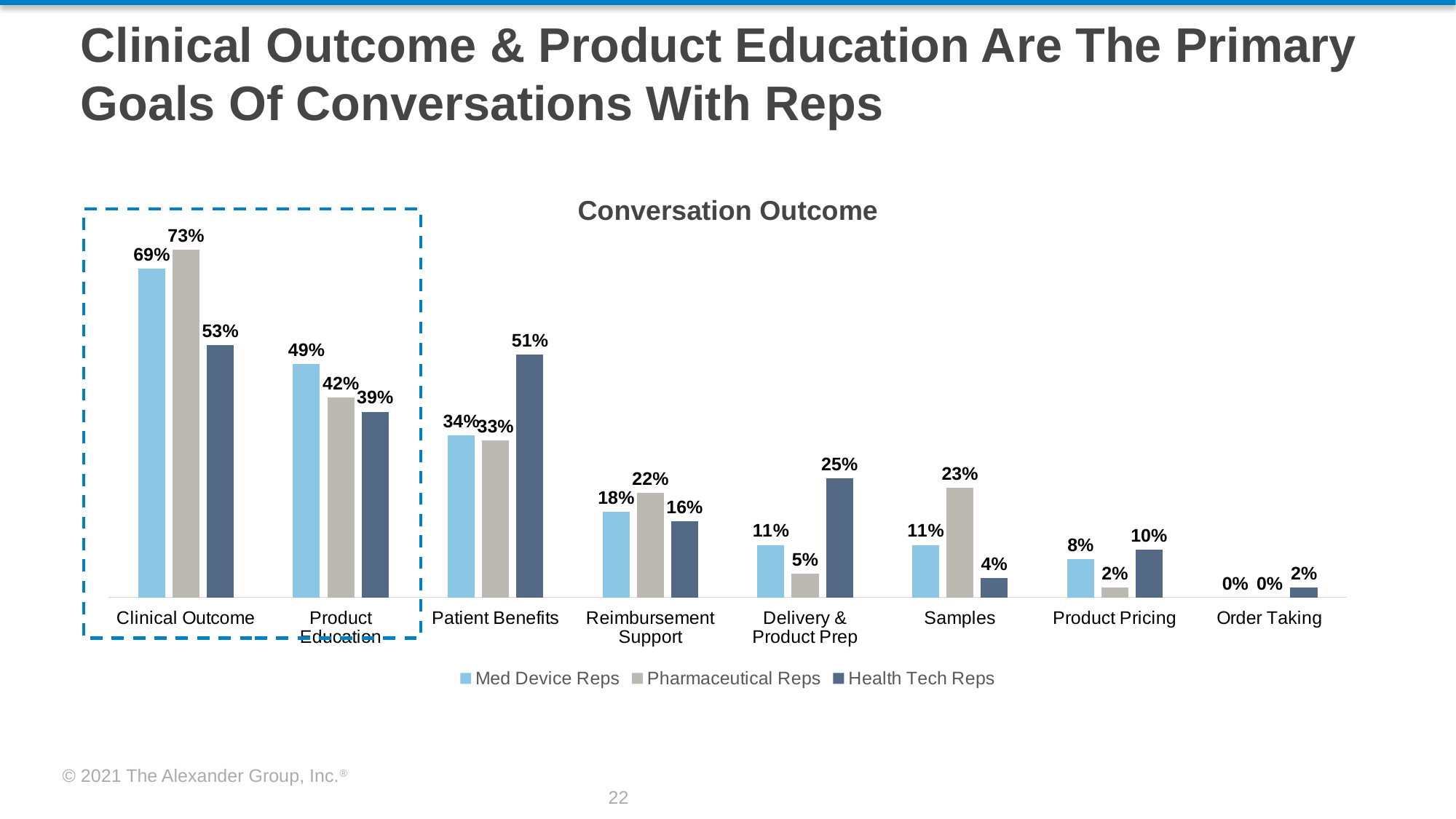
What is the value for Med Device Reps for Clinical Outcome? 69% What is the difference between the Health Tech Reps and Pharmaceutical Reps values for Delivery & Product Prep? 20% What is the title of the chart? Conversation Outcome Which category has the lowest value for Health Tech Reps? Order Taking How many series does the legend list? 3 How many categories are shown on the x axis? 8 What is the difference between the Pharmaceutical Reps and Med Device Reps values for Clinical Outcome? 4% What is the value for Health Tech Reps for Patient Benefits? 51% What kind of chart is shown on the slide? Bar chart What is the value for Pharmaceutical Reps for Samples? 23% Which category has the highest value for Pharmaceutical Reps? Clinical Outcome Which is larger for Product Education: Med Device Reps or Health Tech Reps? Med Device Reps